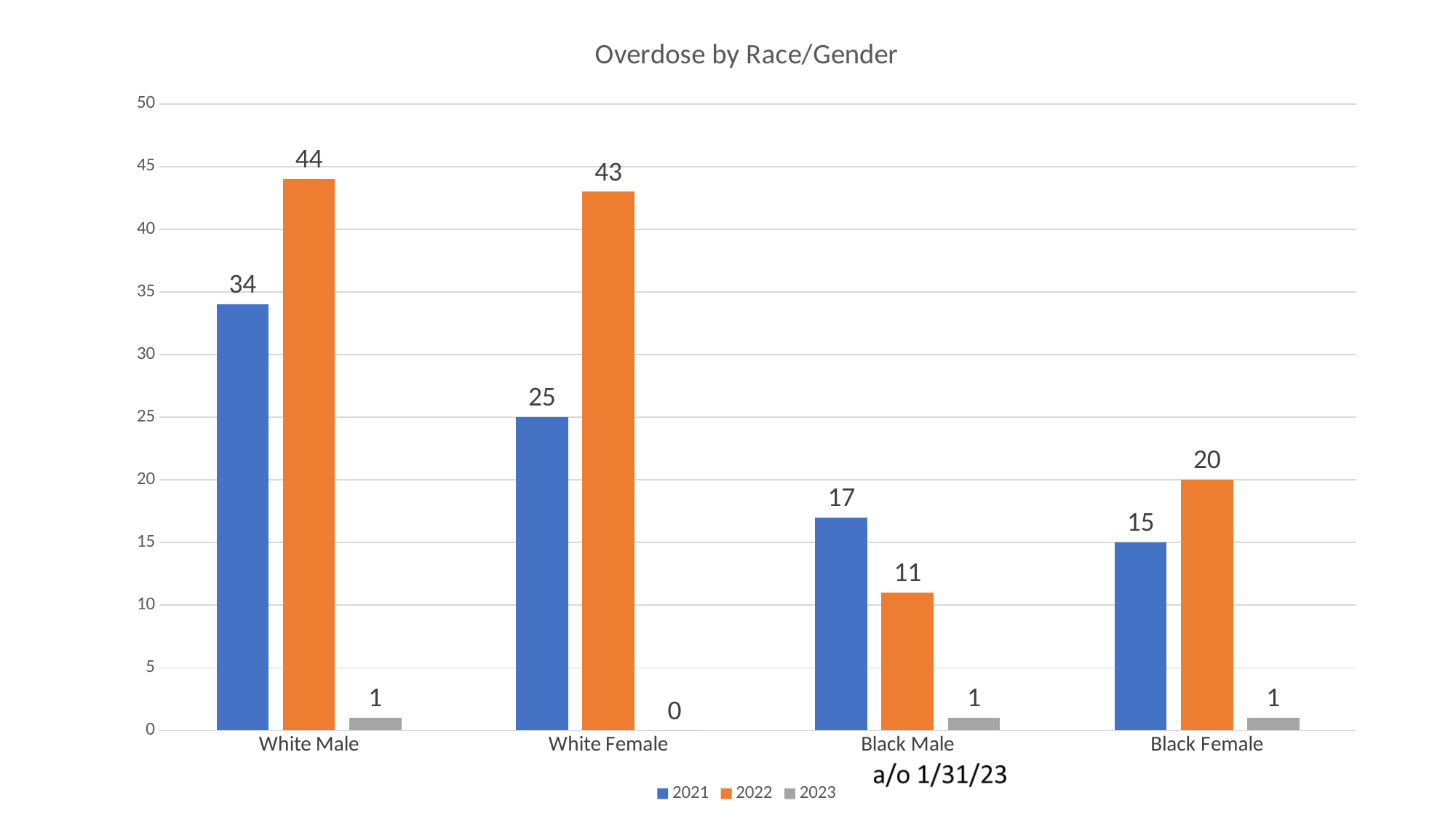
What is the difference between the 2022 and 2021 values for White Female? 18 Which category has the lowest 2021 value? Black Female What kind of chart is this? Bar chart What is the 2022 value for White Male? 44 Which colour represents the 2023 series? Gray How many series does the legend list? 3 What is the 2023 value for White Female? 0 Which category has the highest 2022 value? White Male For Black Male, which is larger, the 2021 value or the 2022 value? 2021 What is the 2021 value for Black Female? 15 How many categories are shown on the x axis? 4 What is the title of the chart? Overdose by Race/Gender